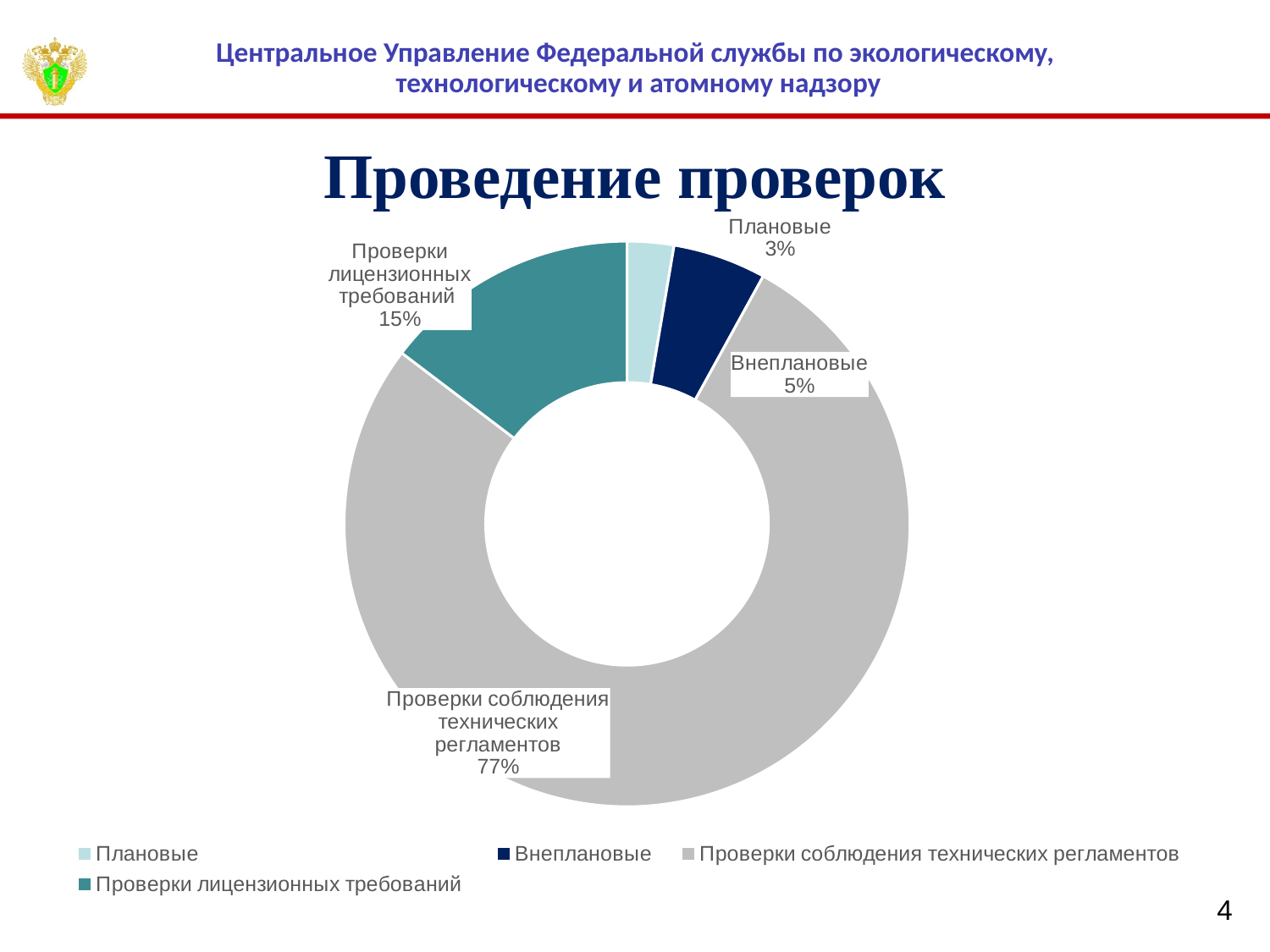
Which is larger: the share for 'Внеплановые' or the share for 'Плановые'? Внеплановые What share of the chart does the 'Внеплановые' slice represent? 5% What share of the chart does 'Проверки соблюдения технических регламентов' represent? 77% How many categories are shown in the chart? 4 Which category has the smallest share of the chart? Плановые What kind of chart is shown on the slide? Doughnut (pie) chart What share of the chart does 'Проверки лицензионных требований' represent? 15% Which category has the largest share of the chart? Проверки соблюдения технических регламентов What is the title of the chart? Проведение проверок How many entries does the legend list? 4 What share of the chart does the 'Плановые' slice represent? 3% What is the difference in percentage points between 'Проверки соблюдения технических регламентов' and 'Проверки лицензионных требований'? 62